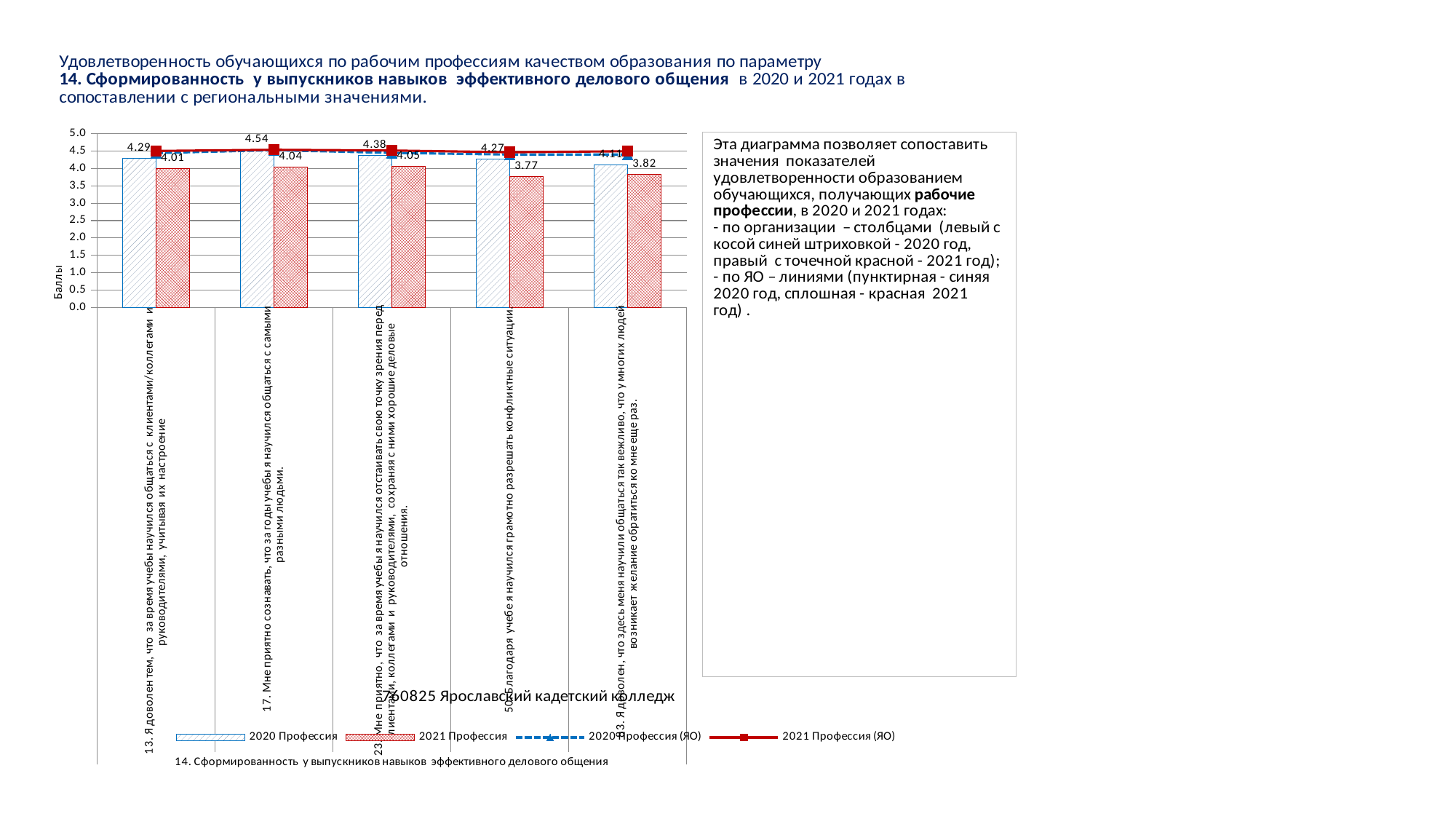
How many statements (categories) are plotted on the x axis? 5 Is the 2021 Профессия (ЯО) line value for statement 13 greater or less than 4.0? greater What is the 2020 Профессия value for statement 17 ("Мне приятно сознавать, что за годы учебы я научился общаться с самыми разными людьми")? 4.54 What kind of chart is shown? Bar chart combined with line series Which statement has the highest 2020 Профессия value? 17 (4.54) For statement 13, which is larger: the 2020 Профессия value or the 2021 Профессия value? 2020 Профессия (4.29) How many series does the legend list? 4 What is the difference between the 2020 Профессия and 2021 Профессия values for statement 17? 0.50 What is the title of the vertical axis? Баллы What is the 2021 Профессия value for statement 50 ("Благодаря учебе я научился грамотно разрешать конфликтные ситуации")? 3.77 Which statement has the lowest 2021 Профессия value? 50 (3.77)